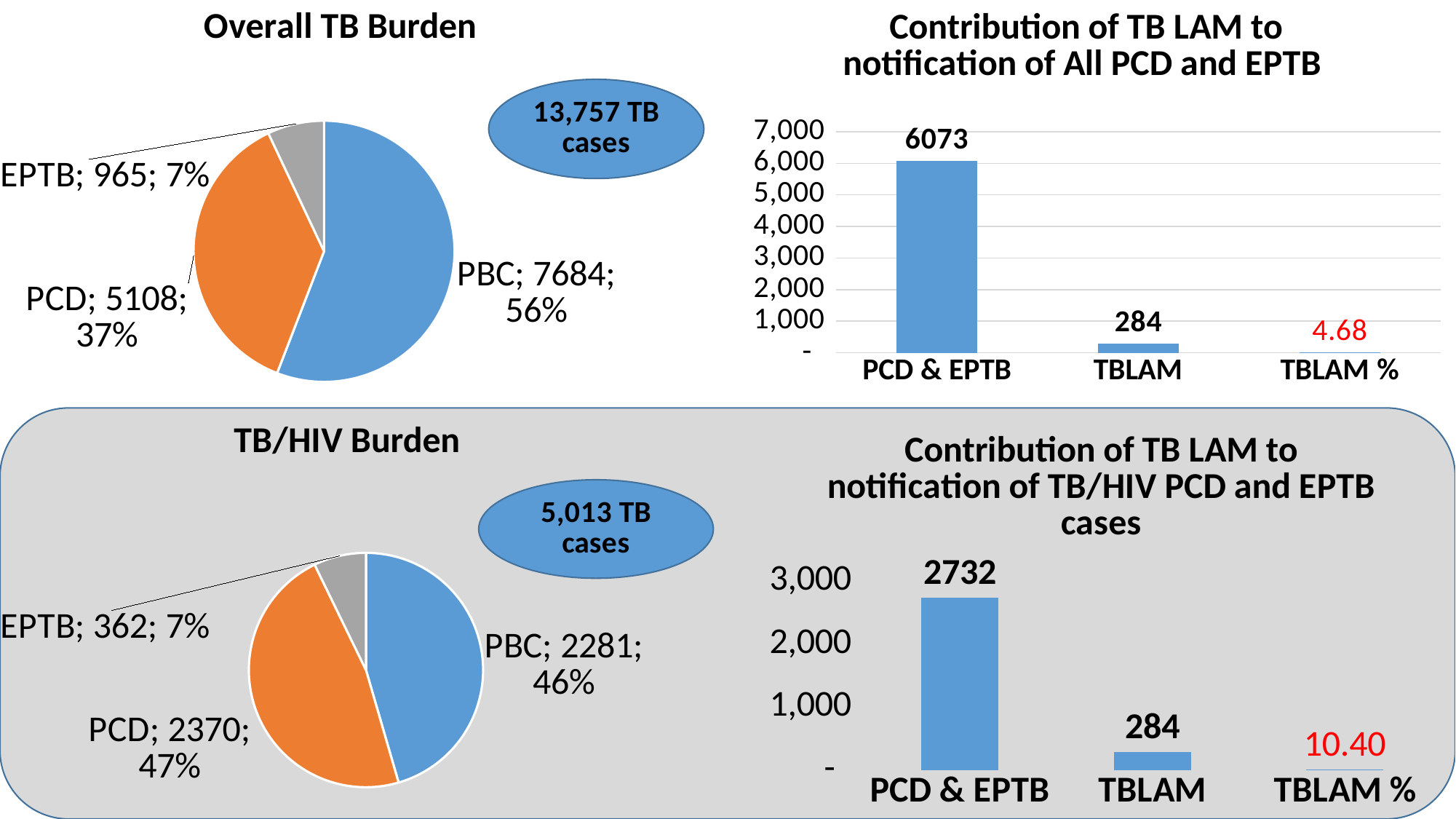
In the 'Overall TB Burden' pie chart, what share of the pie does PCD represent? 37% In the 'Overall TB Burden' pie chart, which category has the smallest slice? EPTB In the 'Overall TB Burden' pie chart, what is the value for PBC? 7684 In the 'Contribution of TB LAM to notification of All PCD and EPTB' chart, what is the value for PCD & EPTB? 6073 In the 'Contribution of TB LAM to notification of All PCD and EPTB' chart, what is the value for TBLAM %? 4.68 In the 'Contribution of TB LAM to notification of TB/HIV PCD and EPTB cases' chart, which category has the highest value? PCD & EPTB What kind of chart is the 'Contribution of TB LAM to notification of TB/HIV PCD and EPTB cases' chart? Bar chart In the 'Contribution of TB LAM to notification of All PCD and EPTB' chart, what is the difference between PCD & EPTB and TBLAM? 5789 In the 'TB/HIV Burden' pie chart, how many categories are shown? 3 In the 'Contribution of TB LAM to notification of TB/HIV PCD and EPTB cases' chart, what is the value for TBLAM %? 10.40 In the 'TB/HIV Burden' pie chart, what is the value for PCD? 2370 In the 'TB/HIV Burden' pie chart, what share of the pie does PBC represent? 46%